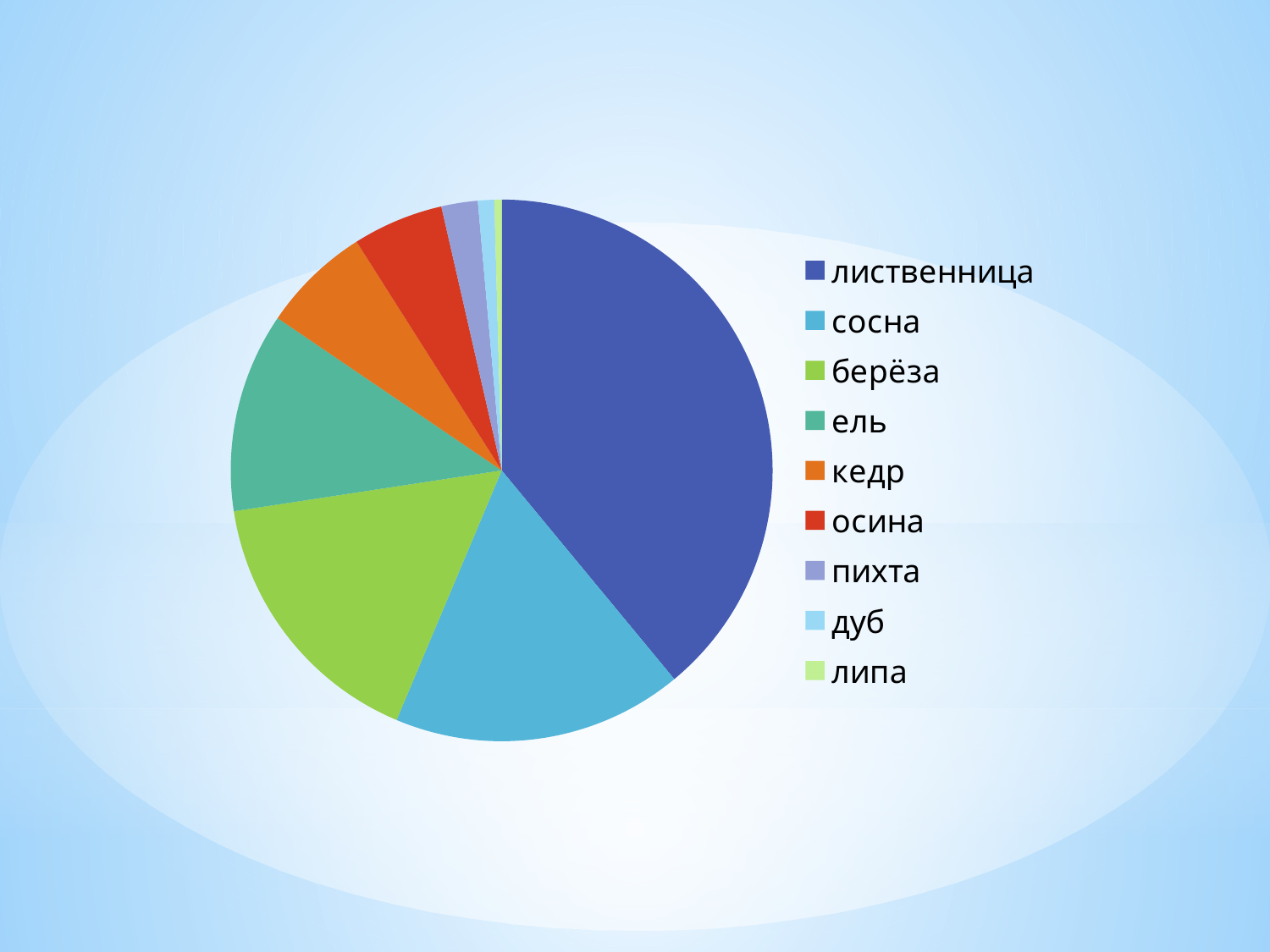
How many categories (slices) does the pie chart have? 9 Which slice is larger, лиственница or берёза? лиственница Which category is listed first in the legend? лиственница Which category has the largest slice of the pie chart? лиственница Which category is listed last in the legend? липа Which slice is larger, лиственница or сосна? лиственница Which slice is larger, ель or кедр? ель What kind of chart is shown on the slide? pie chart How many entries does the legend list? 9